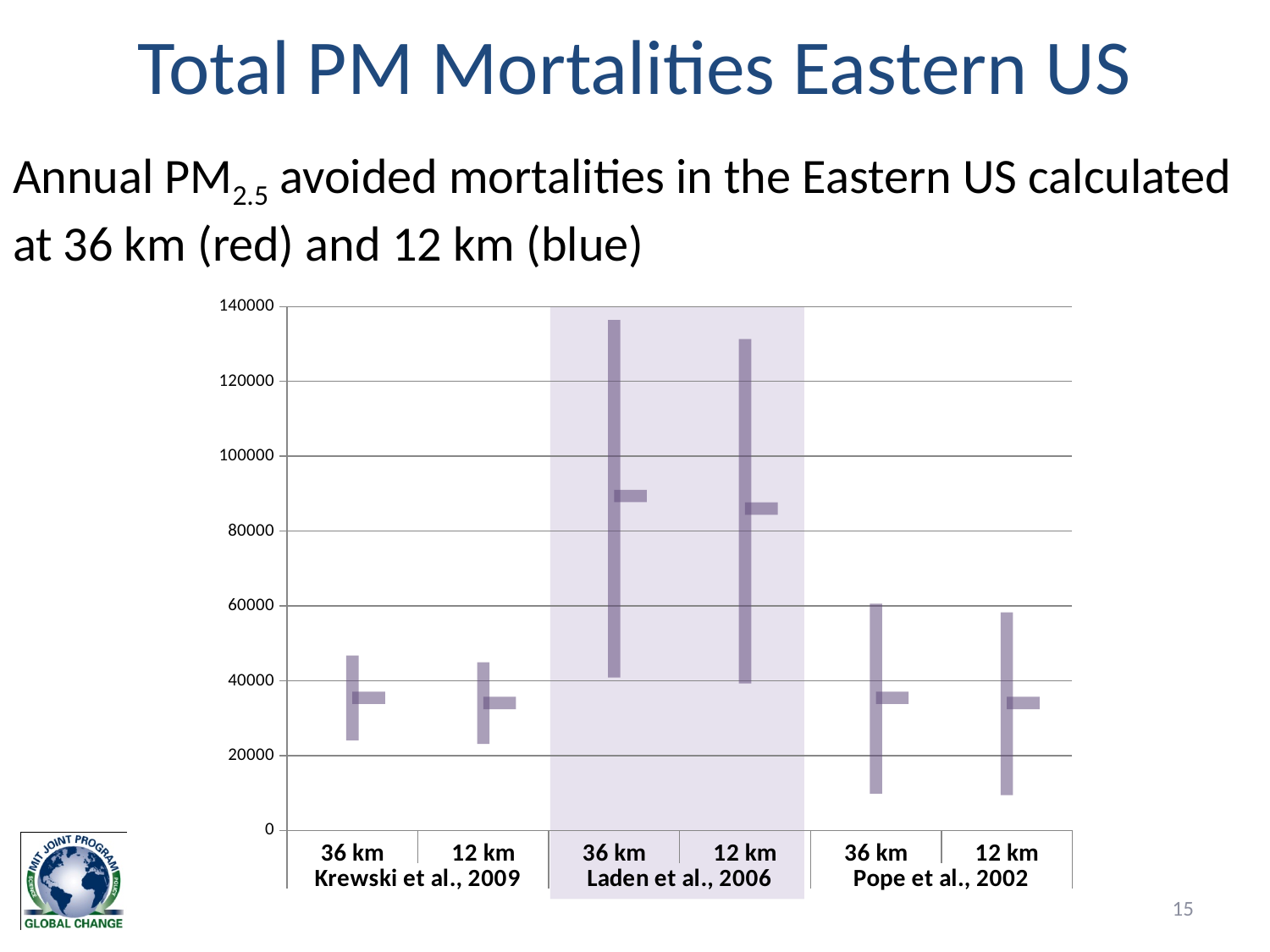
Which study shows the highest avoided mortality values in the chart? Laden et al., 2006 What is the maximum value shown on the chart's vertical axis? 140000 Which study's categories are highlighted with a shaded background in the chart? Laden et al., 2006 Is the central value for Laden et al., 2006 at 12 km greater or less than 80000? greater How many studies are labelled along the x axis of the chart? 3 Is the lower end of the range for Pope et al., 2002 at 36 km greater or less than 20000? less Is the central value for Laden et al., 2006 at 36 km greater or less than 80000? greater How many categories (study/resolution combinations) are shown on the x axis of the chart? 6 Which is larger: the central value for Laden et al., 2006 at 36 km or for Krewski et al., 2009 at 36 km? Laden et al., 2006 at 36 km